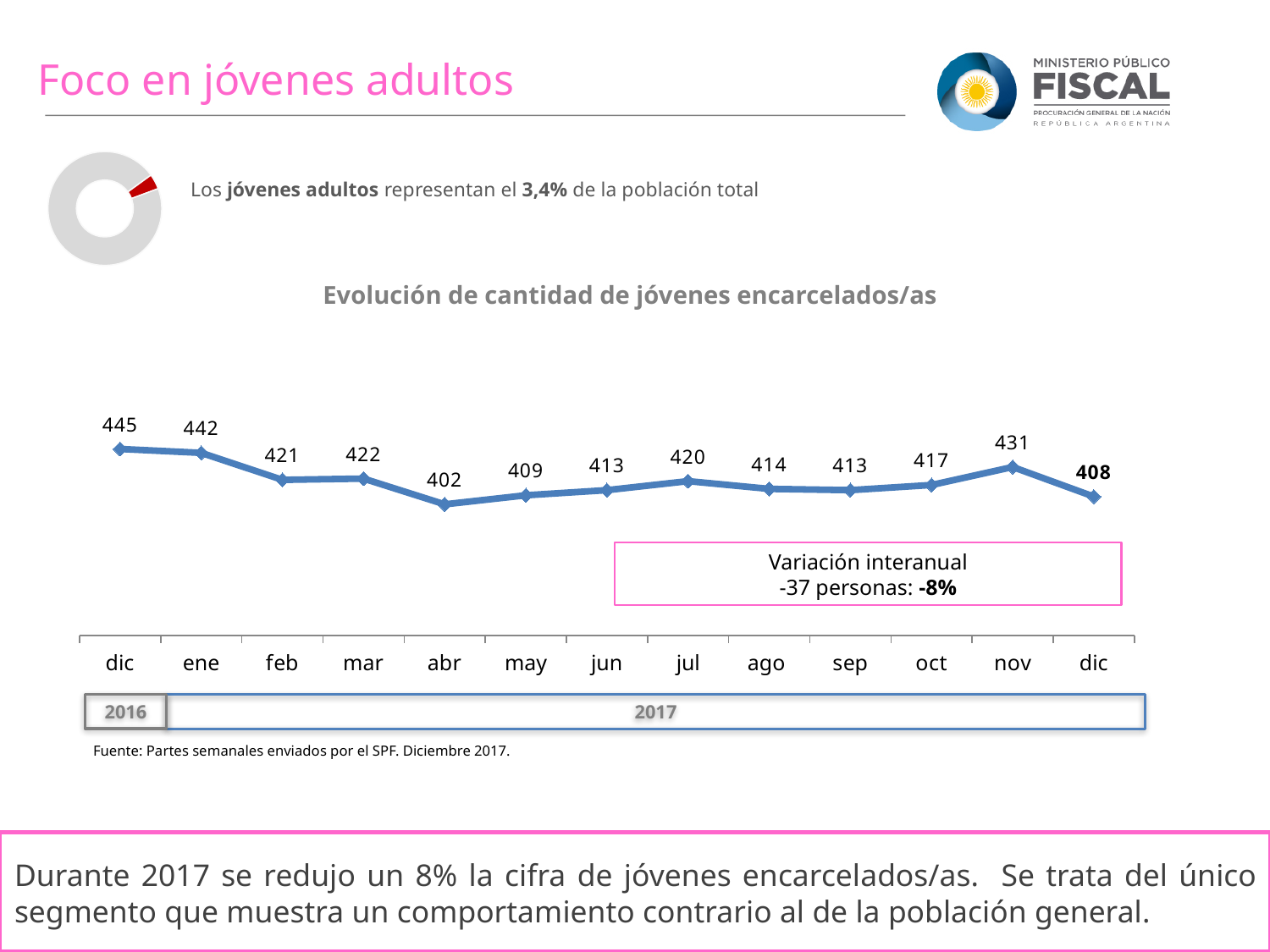
In the chart 'Evolución de cantidad de jóvenes encarcelados/as', what is the value for dic 2017? 408 In the chart 'Evolución de cantidad de jóvenes encarcelados/as', do the values overall rise or fall from dic 2016 to dic 2017? fall In the chart 'Evolución de cantidad de jóvenes encarcelados/as', how many data points are plotted? 13 In the chart 'Evolución de cantidad de jóvenes encarcelados/as', what is the value for dic 2016? 445 According to the donut chart at the top of the slide, what share of the total population do jóvenes adultos represent? 3,4% In the chart 'Evolución de cantidad de jóvenes encarcelados/as', what is the value for nov? 431 What kind of chart is 'Evolución de cantidad de jóvenes encarcelados/as'? line chart In the chart 'Evolución de cantidad de jóvenes encarcelados/as', what is the value for abr? 402 In the chart 'Evolución de cantidad de jóvenes encarcelados/as', which month has the highest value? dic 2016 In the chart 'Evolución de cantidad de jóvenes encarcelados/as', which is larger, the value for jul or the value for ago? jul In the chart 'Evolución de cantidad de jóvenes encarcelados/as', which month has the lowest value? abr In the chart 'Evolución de cantidad de jóvenes encarcelados/as', what is the difference between the values for dic 2016 and dic 2017? 37